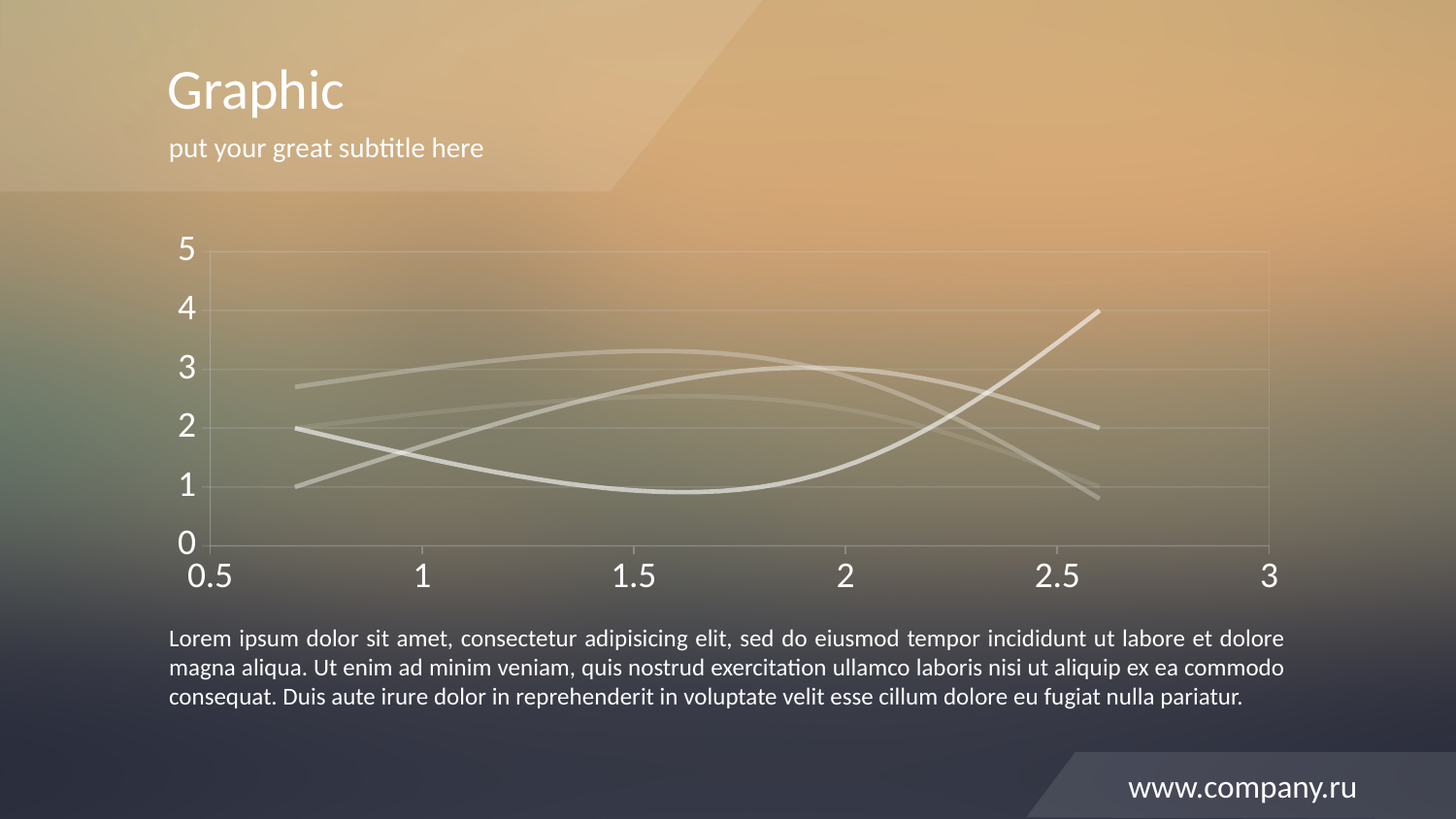
What is the title of the slide containing the chart? Graphic Is the highest point reached by any line on the chart greater or less than 3? greater Does any line on the chart reach a value greater than 5? No What is the highest value shown on the chart's vertical axis? 5 What kind of chart is shown on the slide? line chart Does the chart display a legend? No What is the lowest value shown on the chart's horizontal axis? 0.5 What is the highest value shown on the chart's horizontal axis? 3 How many lines are plotted on the chart? 4